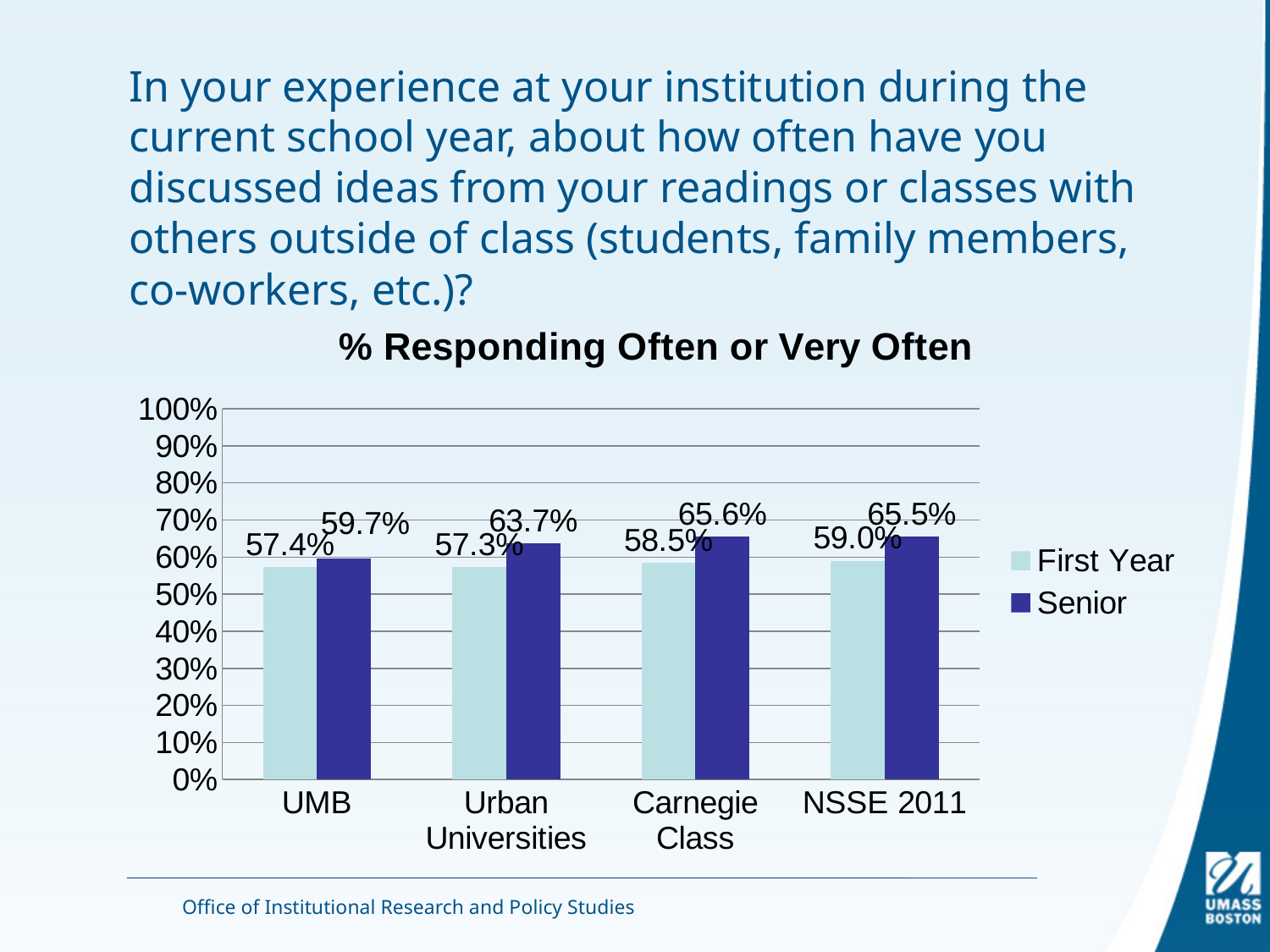
How many categories are shown on the x axis? 4 What is the difference between the Senior and First Year values for UMB? 2.3% What is the difference between the Senior and First Year values for Carnegie Class? 7.1% Which is larger, the Senior value for Urban Universities or the Senior value for UMB? Urban Universities What is the First Year value for UMB? 57.4% What is the First Year value for NSSE 2011? 59.0% What kind of chart is shown on the slide? bar chart How many series does the legend list? 2 What is the Senior value for Carnegie Class? 65.6% Which category has the lowest Senior value? UMB Is the Senior value for NSSE 2011 greater or less than 60%? greater What is the Senior value for Urban Universities? 63.7%